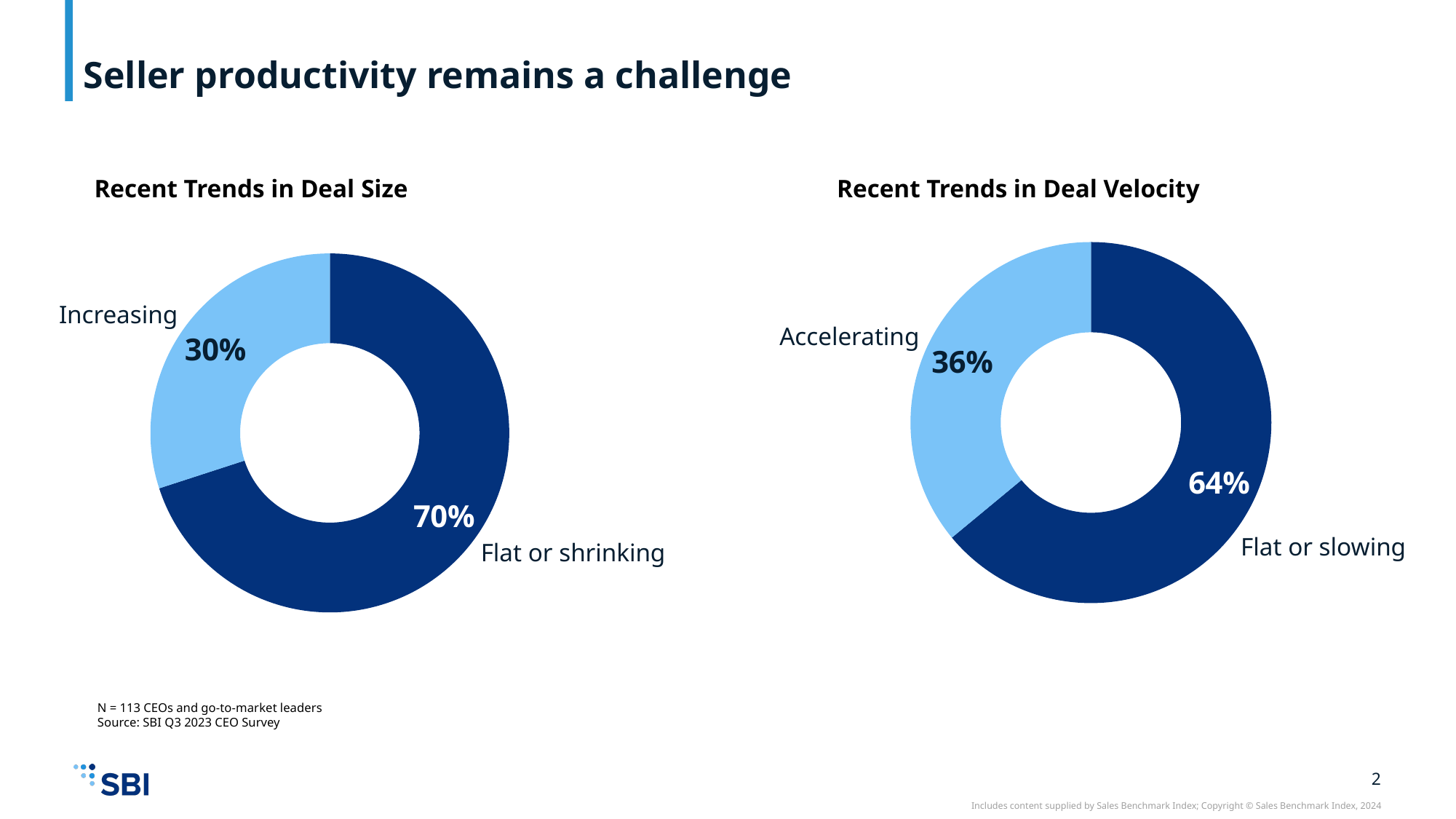
Which is larger: 'Increasing' in the 'Recent Trends in Deal Size' chart or 'Accelerating' in the 'Recent Trends in Deal Velocity' chart? Accelerating In the 'Recent Trends in Deal Size' chart, what percentage is shown for 'Increasing'? 30% In the 'Recent Trends in Deal Size' chart, what percentage is shown for 'Flat or shrinking'? 70% In the 'Recent Trends in Deal Velocity' chart, what percentage is shown for 'Flat or slowing'? 64% In the 'Recent Trends in Deal Velocity' chart, what is the difference in percentage points between 'Flat or slowing' and 'Accelerating'? 28 In the 'Recent Trends in Deal Velocity' chart, what percentage is shown for 'Accelerating'? 36% In the 'Recent Trends in Deal Size' chart, which category has the largest share? Flat or shrinking In the 'Recent Trends in Deal Size' chart, what colour is the 'Increasing' segment? Light blue In the 'Recent Trends in Deal Velocity' chart, which category has the smallest share? Accelerating What kind of chart is the 'Recent Trends in Deal Size' chart? Doughnut chart How many categories does the 'Recent Trends in Deal Velocity' chart show? 2 In the 'Recent Trends in Deal Size' chart, what is the difference in percentage points between 'Flat or shrinking' and 'Increasing'? 40